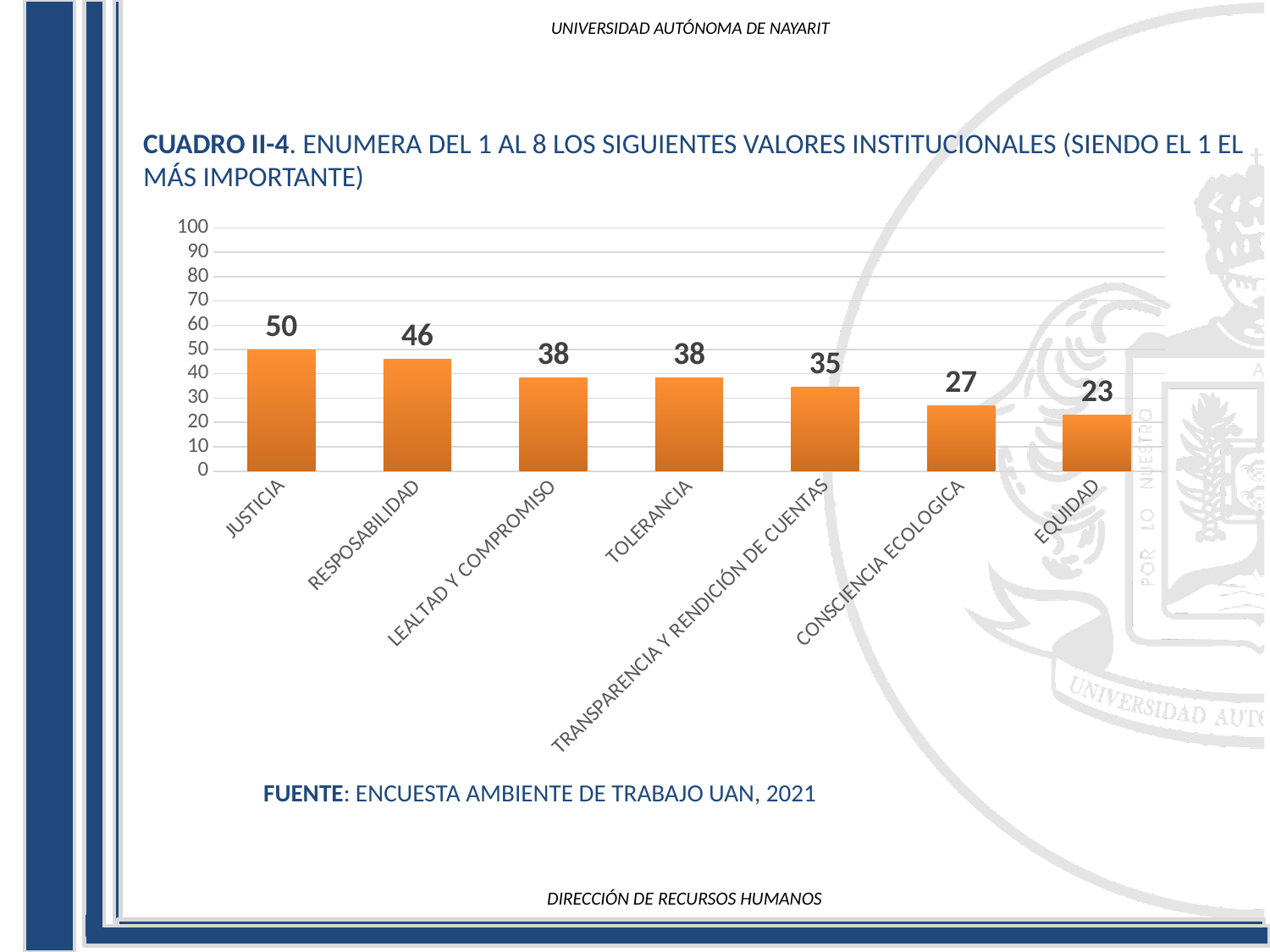
What is the value for CONSCIENCIA ECOLOGICA? 27 What kind of chart is shown on the slide? bar chart Which category has the lowest value? EQUIDAD What is the difference between the values for JUSTICIA and EQUIDAD? 27 How many categories are shown in the chart? 7 Do the values rise or fall from left to right along the x axis? fall What is the difference between the values for RESPOSABILIDAD and TOLERANCIA? 8 Which is larger, the value for RESPOSABILIDAD or the value for CONSCIENCIA ECOLOGICA? RESPOSABILIDAD What is the value for TRANSPARENCIA Y RENDICIÓN DE CUENTAS? 35 Which category has the highest value? JUSTICIA What is the value for JUSTICIA? 50 Is the value for LEALTAD Y COMPROMISO greater or less than 50? less